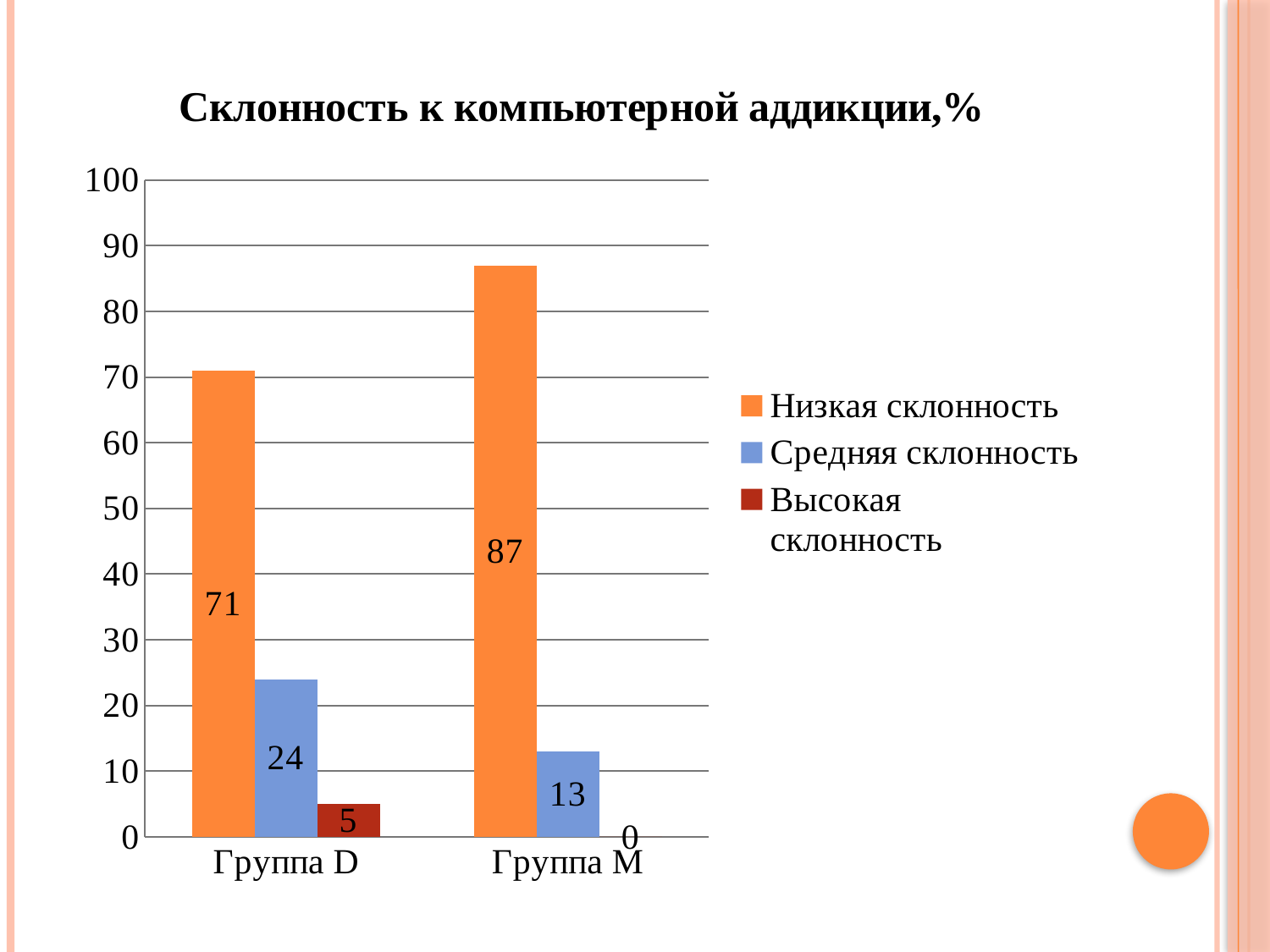
Which is larger: Средняя склонность in Группа D or in Группа M? Группа D What is the value for Средняя склонность in Группа M? 13 What is the value for Высокая склонность in Группа M? 0 What is the difference between Низкая склонность in Группа M and Группа D? 16 How many groups are shown on the x axis? 2 What is the value for Низкая склонность in Группа D? 71 How many series does the legend list? 3 What is the value for Высокая склонность in Группа D? 5 Which series has the lowest value in Группа D? Высокая склонность What kind of chart is shown on the slide? Bar chart What is the title of the chart? Склонность к компьютерной аддикции,% Which group has the highest value for Низкая склонность? Группа M